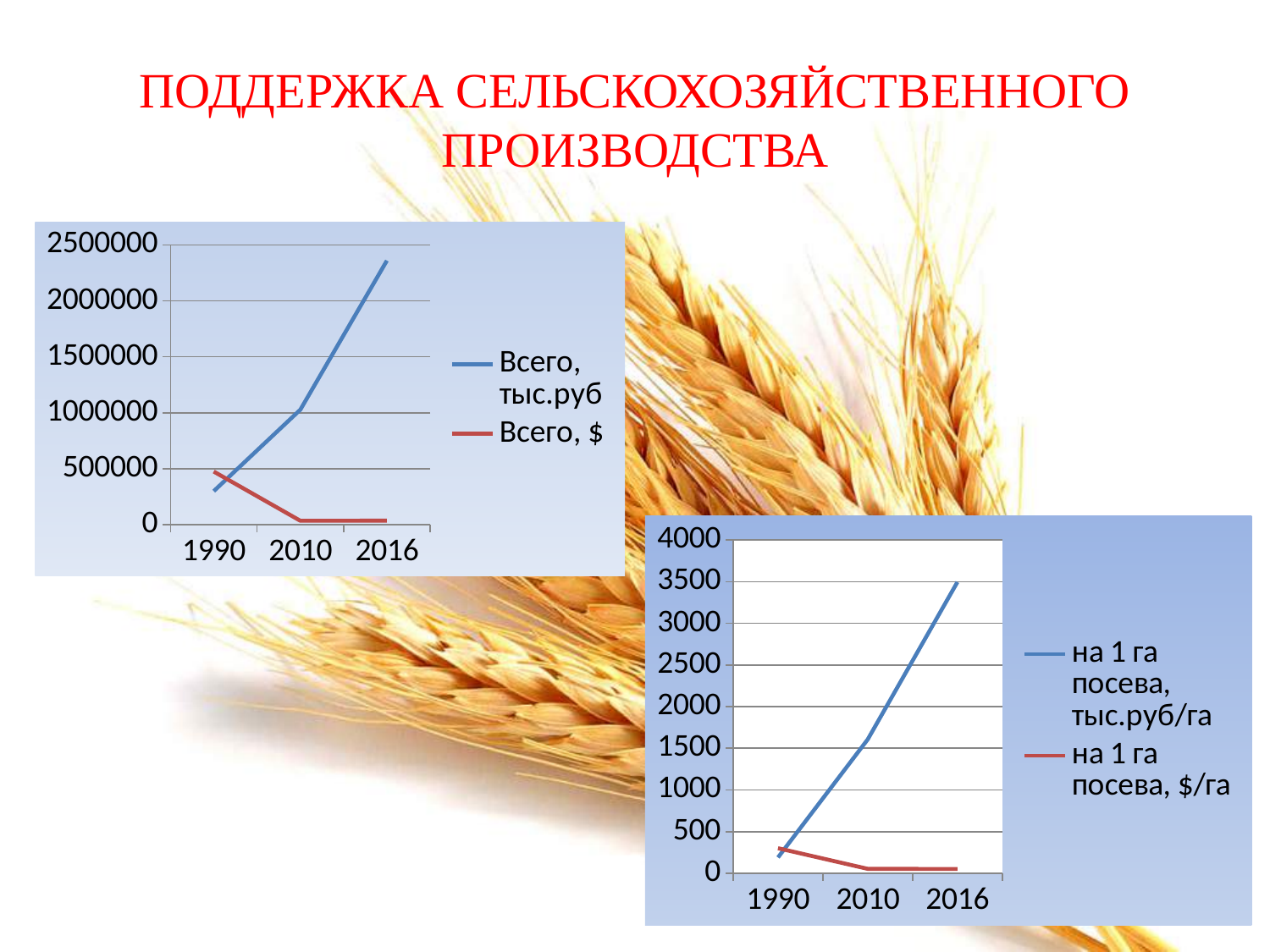
In the top-left chart, is the value of 'Всего, $' in 2010 greater or less than 500000? less What colour is the line for 'на 1 га посева, $/га' in the bottom-right chart? red In the bottom-right chart, which series has the larger value in 2016: 'на 1 га посева, тыс.руб/га' or 'на 1 га посева, $/га'? на 1 га посева, тыс.руб/га In the top-left chart, is the value of 'Всего, тыс.руб' in 2016 greater or less than 2000000? greater How many series does the legend of the top-left chart list? 2 What kind of chart is the top-left chart? line chart In the bottom-right chart, is the value of 'на 1 га посева, тыс.руб/га' in 1990 greater or less than 500? less In the top-left chart, does the 'Всего, $' series rise or fall from 1990 to 2010? fall How many years are shown on the x axis of the bottom-right chart? 3 In the top-left chart, does the 'Всего, тыс.руб' series rise or fall from 1990 to 2016? rise In the top-left chart, which year has the highest value for 'Всего, тыс.руб'? 2016